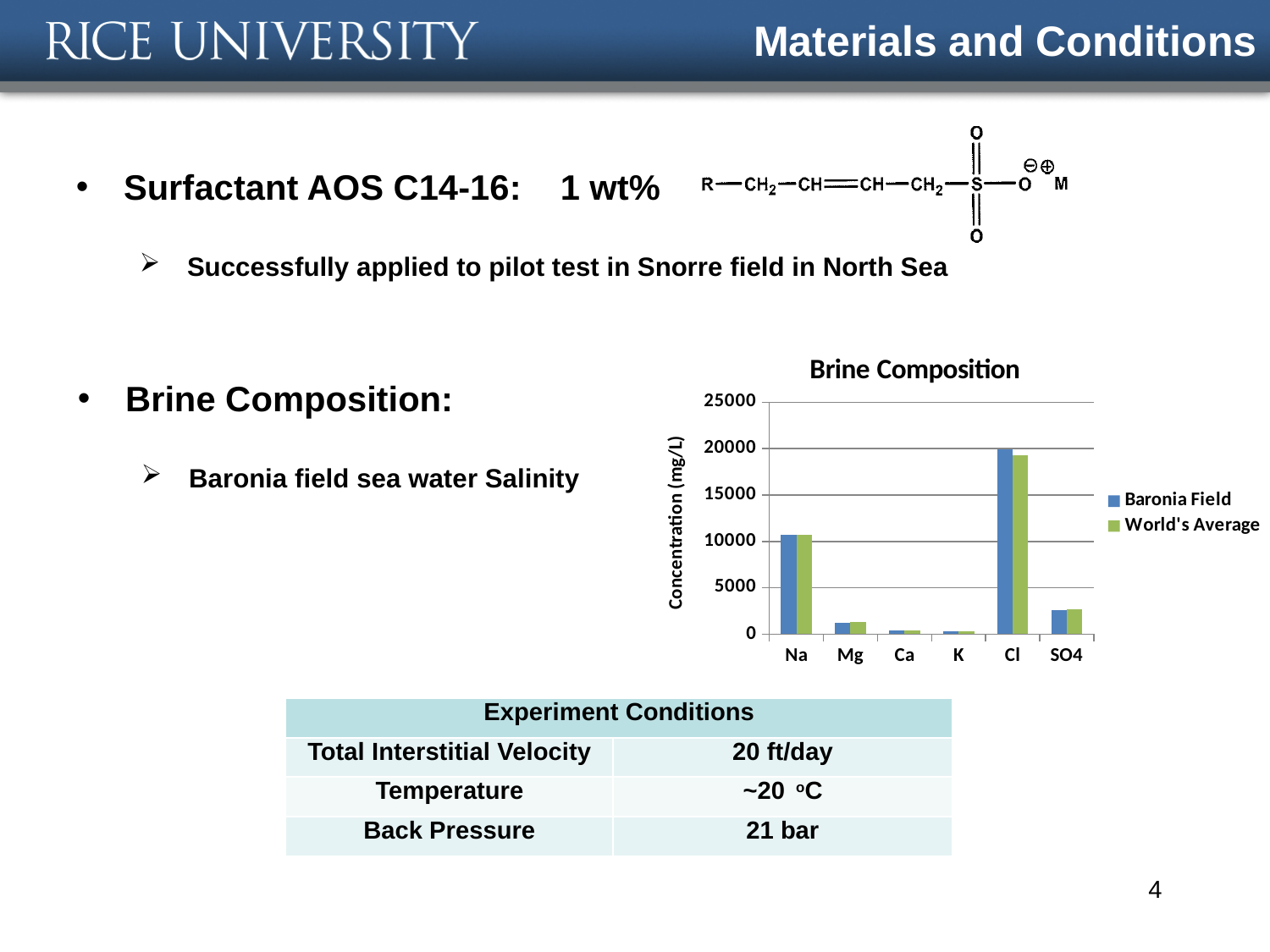
How many ion categories are shown on the x axis of the Brine Composition chart? 6 In the Brine Composition chart, is the Baronia Field value for Mg greater or less than 5000? less In the Brine Composition chart, which has the larger Baronia Field concentration, Na or Cl? Cl What kind of chart is the Brine Composition chart? bar chart Which ion has the highest concentration in the Brine Composition chart? Cl In the Brine Composition chart, is the Baronia Field value for Na greater or less than 10000? greater What is the y-axis title of the Brine Composition chart? Concentration (mg/L) In the Brine Composition chart, is the Baronia Field value for Cl greater or less than 15000? greater In the Brine Composition chart, which has the larger World's Average concentration, Na or SO4? Na How many series does the legend of the Brine Composition chart list? 2 Which series in the Brine Composition chart is shown in green? World's Average